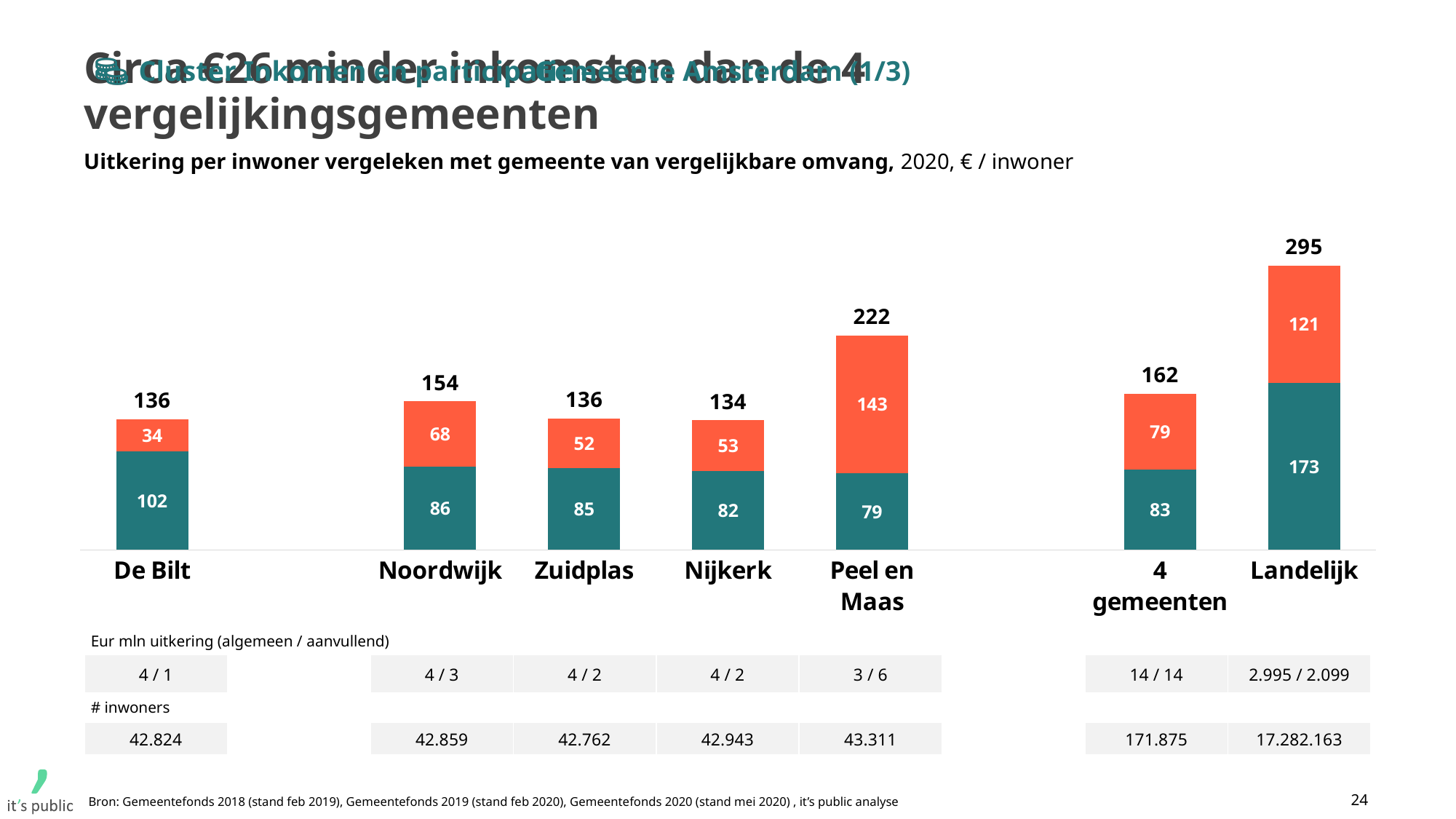
Which category has the lowest total value? Nijkerk What unit is stated in the chart subtitle for the values? € / inwoner What is the difference between the bottom (teal) segment for De Bilt and the bottom (teal) segment for Peel en Maas? 23 Which category has the highest total value? Landelijk What is the value of the bottom (teal) segment for De Bilt? 102 What is the total value of the stacked bar for Peel en Maas? 222 How many categories are shown on the x axis of the chart? 7 What kind of chart is shown on the slide? Stacked bar chart What is the difference between the total for Landelijk and the total for 4 gemeenten? 133 What is the value of the bottom (teal) segment for Landelijk? 173 What is the value of the top (orange) segment for Noordwijk? 68 Which is larger: the top (orange) segment for Peel en Maas or the top (orange) segment for Zuidplas? Peel en Maas